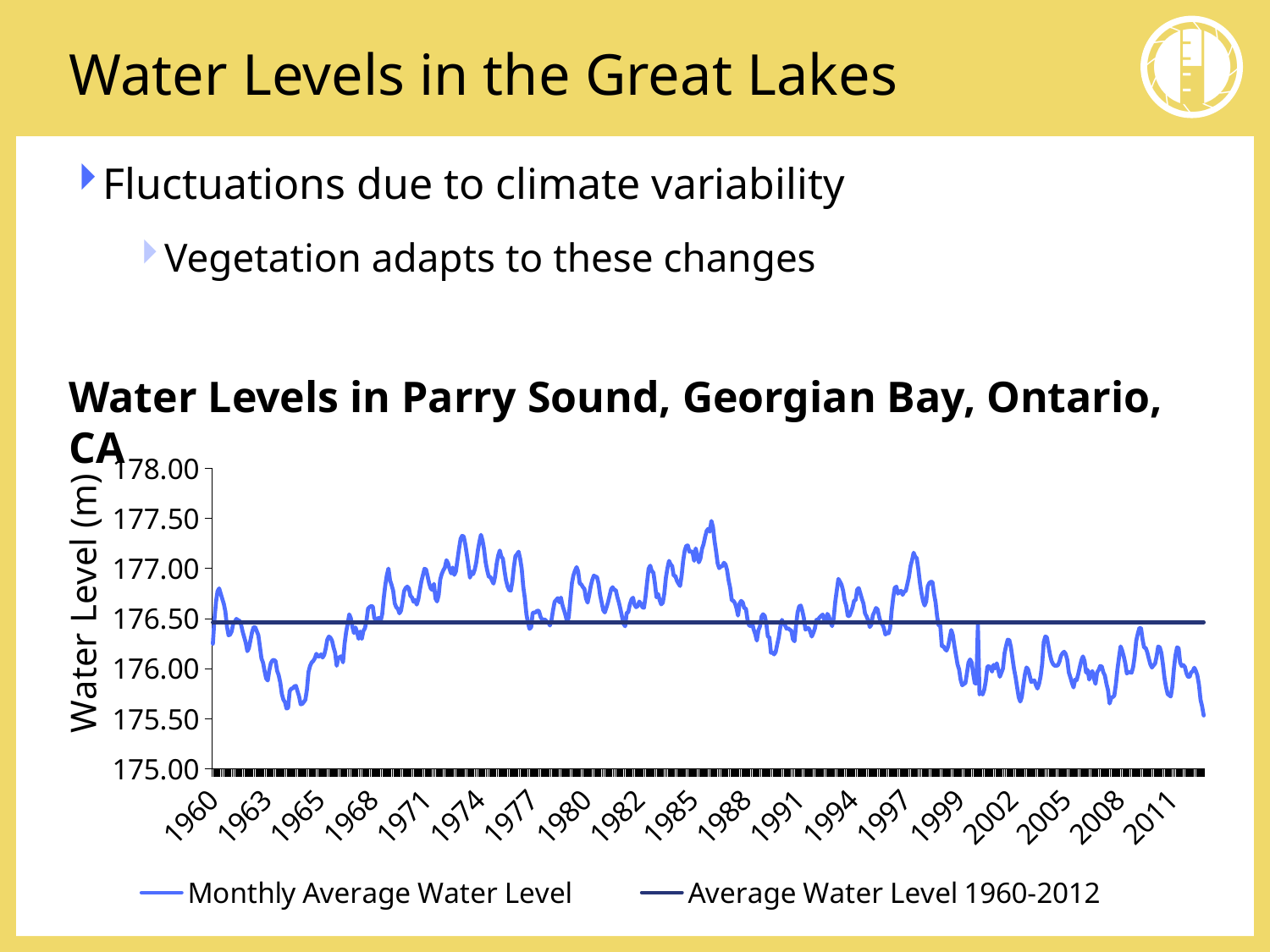
Is the Average Water Level 1960-2012 line greater or less than 176.00? greater Overall, does the Monthly Average Water Level rise or fall from 1960 to the end of the series in 2012? fall Is the peak Monthly Average Water Level around 1986 greater or less than 177.00? greater Is the Monthly Average Water Level around 1964 greater or less than 176.00? less Around which year does the Monthly Average Water Level reach its highest point? 1986 What is the label on the vertical axis of the chart? Water Level (m) How many series does the chart legend list? 2 What is the title of the chart? Water Levels in Parry Sound, Georgian Bay, Ontario, CA Is the Monthly Average Water Level higher around 1986 or around 2000? 1986 What kind of chart is shown on the slide? Line chart